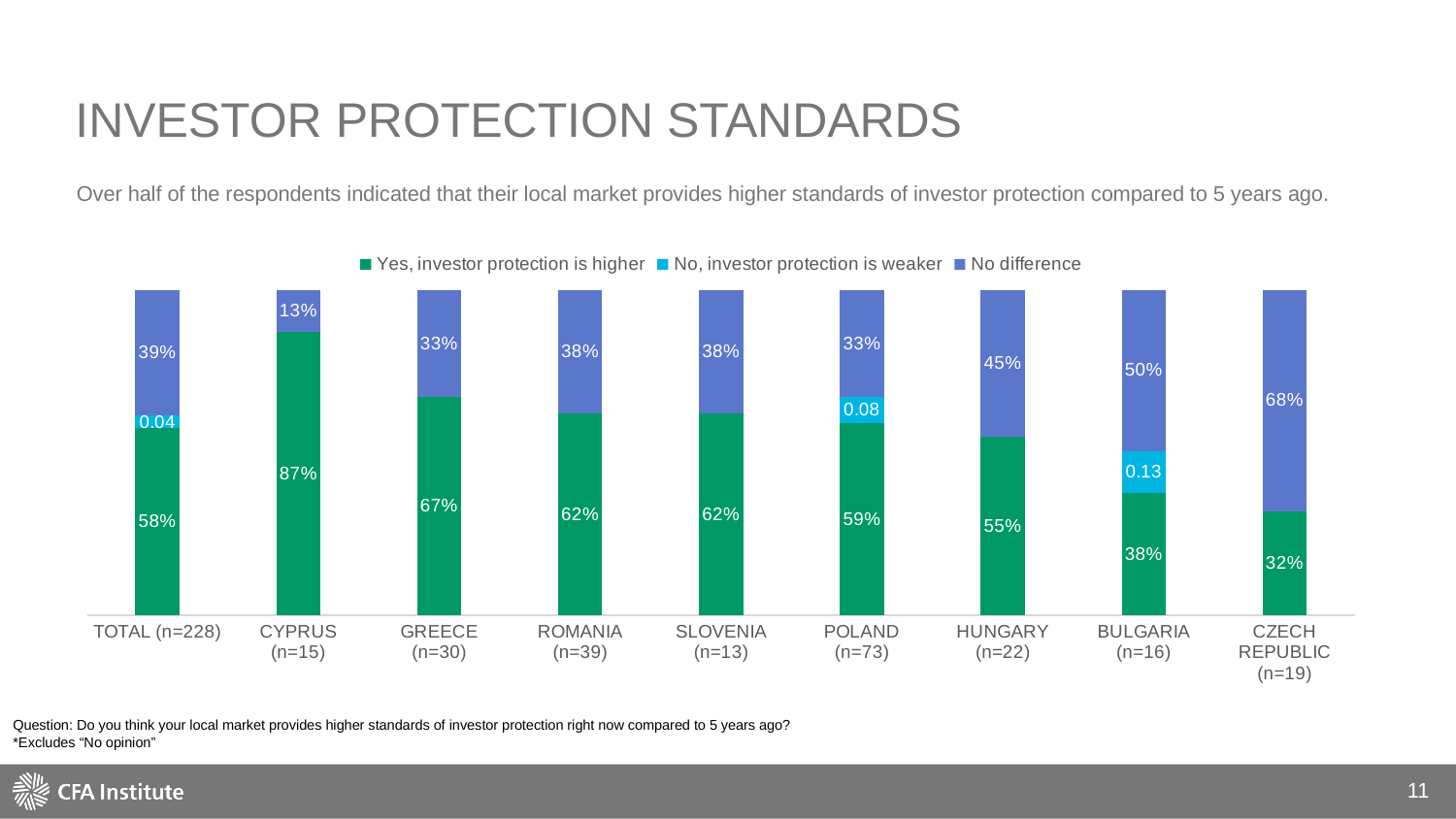
What is the difference between the 'Yes, investor protection is higher' values for Greece and Hungary? 12% Which country has the highest 'Yes, investor protection is higher' value? Cyprus What type of chart is shown on the slide? Stacked bar chart What is the 'No difference' value for the Czech Republic? 68% What percentage of respondents in Cyprus said investor protection is higher? 87% What is the 'No, investor protection is weaker' value shown for Bulgaria? 0.13 How many countries/categories are shown on the x axis? 9 Which has a larger 'No difference' value, Bulgaria or Hungary? Bulgaria Which legend entry is shown in green? Yes, investor protection is higher Which country has the lowest 'Yes, investor protection is higher' value? Czech Republic What is the 'Yes, investor protection is higher' value for TOTAL (n=228)? 58% How many series does the legend list? 3